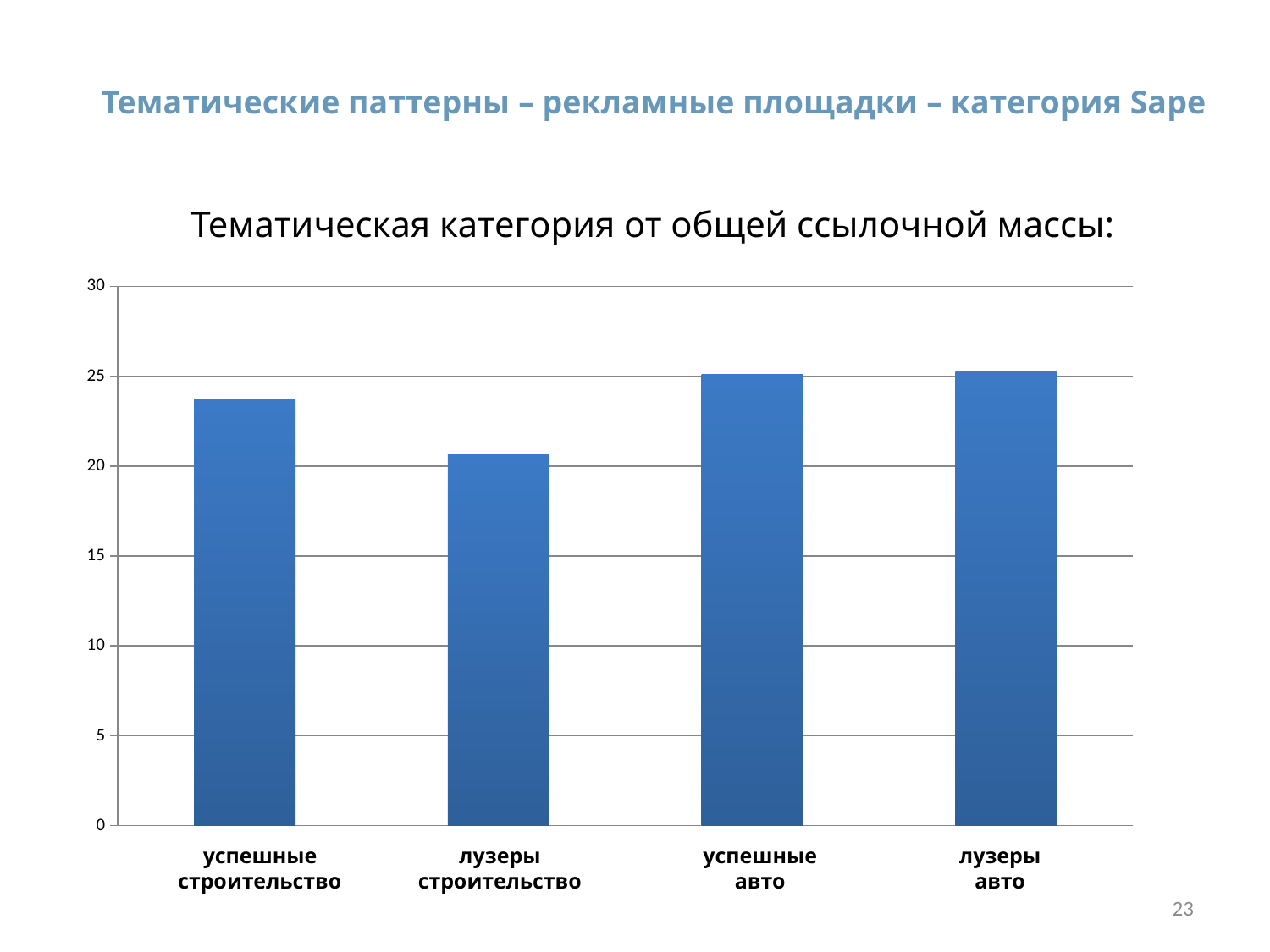
What is the title of the chart? Тематическая категория от общей ссылочной массы: Is the value for успешные строительство greater or less than 20? greater How many categories are plotted in the chart? 4 What kind of chart is shown on the slide? bar chart Which is larger: the value for успешные строительство or for лузеры авто? лузеры авто Is the value for успешные строительство greater or less than 25? less Is the value for успешные авто greater or less than 20? greater Which category has the lowest value in the chart? лузеры строительство Which is larger: the value for лузеры строительство or for успешные авто? успешные авто Which is larger: the value for успешные строительство or for лузеры строительство? успешные строительство